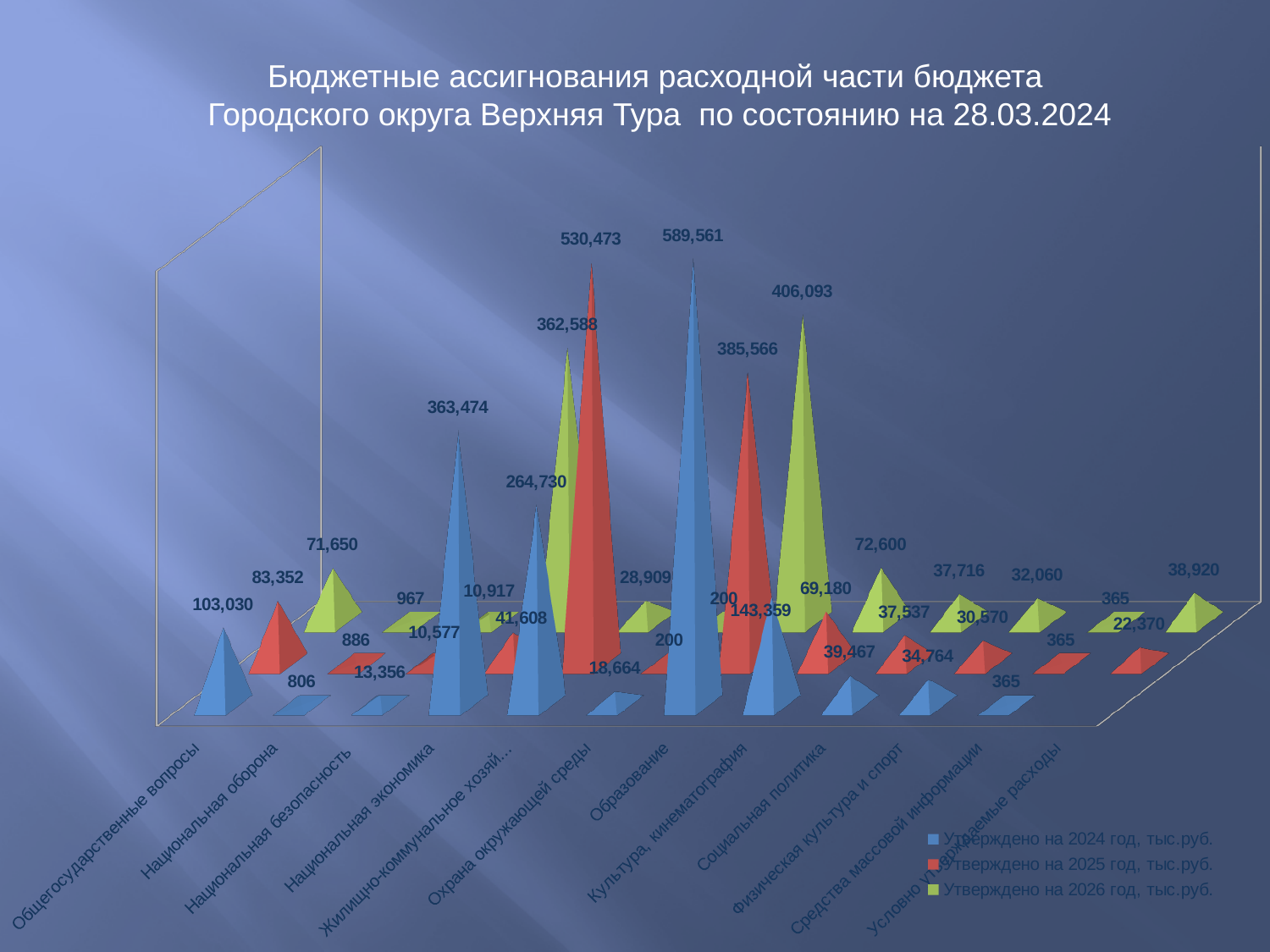
How many expenditure categories are shown along the x axis? 12 Which colour represents the series Утверждено на 2024 год, тыс.руб.? blue What is the value for Общегосударственные вопросы in the series Утверждено на 2024 год? 103,030 What kind of chart is shown on the slide? bar chart What is the value for Национальная оборона in the series Утверждено на 2026 год? 967 What is the value for Условно утверждаемые расходы in the series Утверждено на 2026 год? 38,920 Which category has the highest value in the series Утверждено на 2024 год? Образование Do the values for Общегосударственные вопросы rise or fall from 2024 to 2026? fall What is the difference between the 2024 and 2025 values for Общегосударственные вопросы? 19,678 For Образование, which is larger: the value approved for 2025 or for 2026? 2026 (406,093) How many series does the legend list? 3 What is the value for Образование in the series Утверждено на 2024 год? 589,561